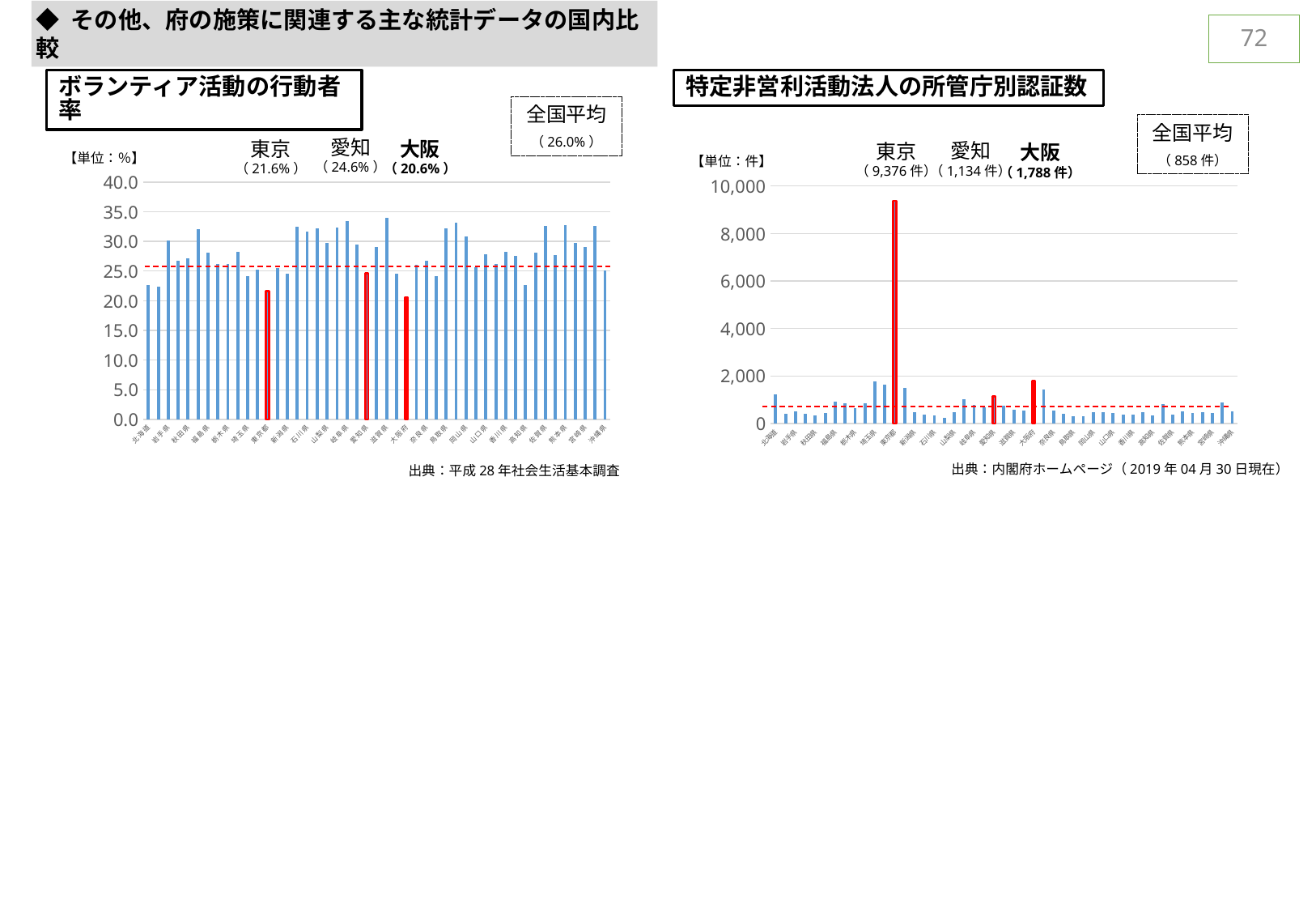
In the right chart (特定非営利活動法人の所管庁別認証数), what is the value for 大阪? 1,788件 In the left chart (ボランティア活動の行動者率), what is the value for 大阪? 20.6% In the right chart (特定非営利活動法人の所管庁別認証数), what is the difference between the values for 東京 and 大阪? 7,588件 In the left chart (ボランティア活動の行動者率), what is the difference between the values for 愛知 and 大阪? 4.0% In the left chart (ボランティア活動の行動者率), what is the value for 愛知? 24.6% In the right chart (特定非営利活動法人の所管庁別認証数), which prefecture has the highest value? 東京 In the right chart (特定非営利活動法人の所管庁別認証数), what is the value for 東京? 9,376件 In the left chart (ボランティア活動の行動者率), what is the value for 東京? 21.6% What kind of chart is the right chart (特定非営利活動法人の所管庁別認証数)? bar chart In the left chart (ボランティア活動の行動者率), what is the national average (全国平均) shown? 26.0% In the left chart (ボランティア活動の行動者率), which is larger, the value for 愛知 or the value for 大阪? 愛知 In the right chart (特定非営利活動法人の所管庁別認証数), what is the value for 愛知? 1,134件